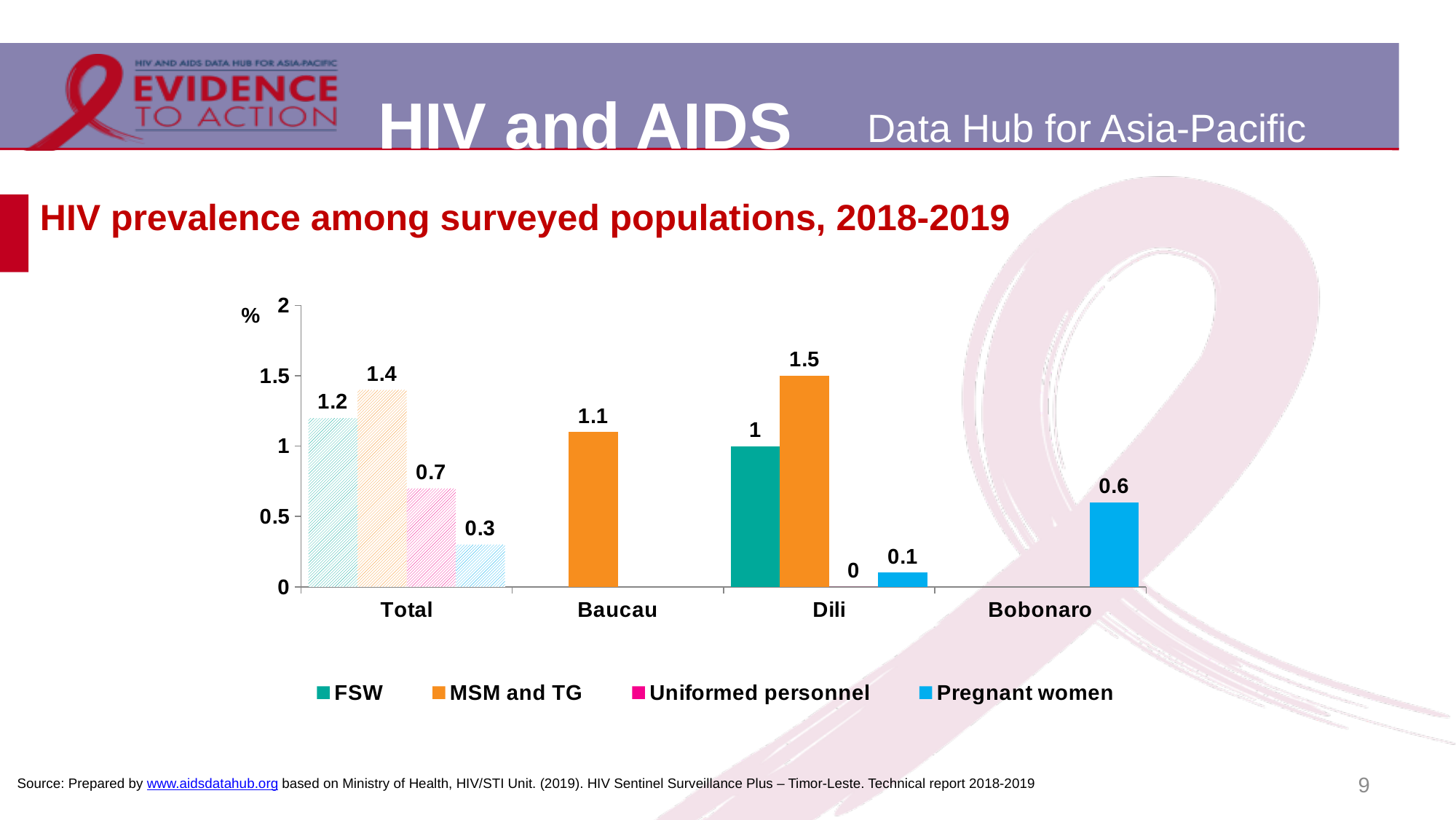
Which series has the lowest HIV prevalence in Dili? Uniformed personnel What is the HIV prevalence among MSM and TG in Baucau? 1.1 How many series does the legend list? 4 Is the HIV prevalence among pregnant women higher in Bobonaro or in Dili? Bobonaro What is the difference between the HIV prevalence among MSM and TG and among FSW in Dili? 0.5 What is the HIV prevalence among MSM and TG in Dili? 1.5 What is the HIV prevalence among uniformed personnel in the Total category? 0.7 What is the HIV prevalence among pregnant women in Bobonaro? 0.6 How many location categories are shown on the x axis? 4 Which series has the highest HIV prevalence in the Total category? MSM and TG What unit is shown on the y axis of the chart? % What type of chart is shown on the slide? Bar chart